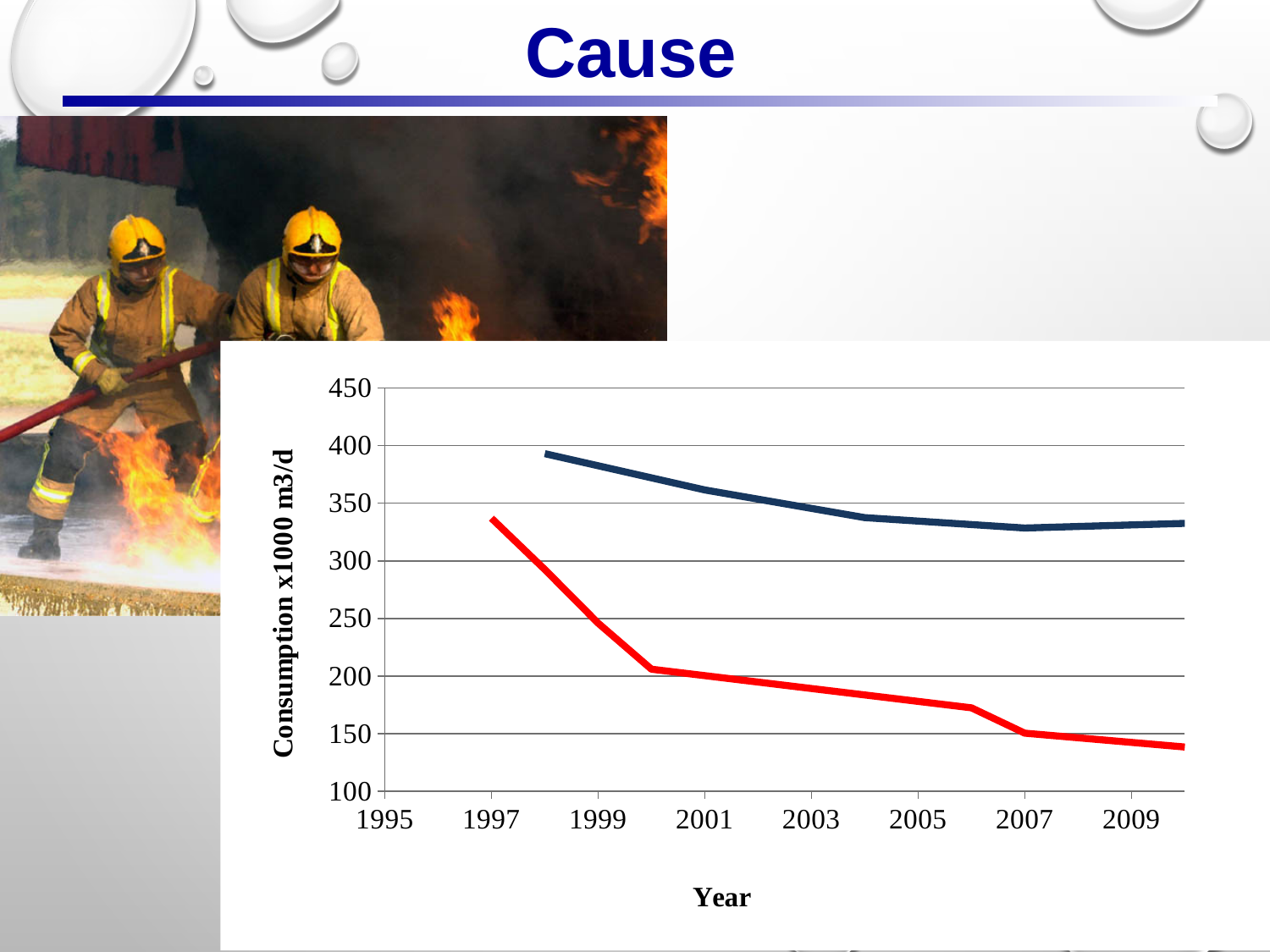
Does the red line rise or fall from 1997 to 2010? Fall Is the value of the red line in 2006 greater or less than 150? greater In 2005, which line has the higher value, the red line or the dark blue line? The dark blue line What is the title of the horizontal axis of the chart? Year Is the value of the dark blue line in 2007 greater or less than 300? greater What kind of chart is shown on the slide? Line chart How many lines are plotted on the chart? 2 Is the value of the dark blue line in 1998 greater or less than 400? less Does the dark blue line rise or fall from 1998 to 2007? Fall What is the title of the vertical axis of the chart? Consumption x1000 m3/d